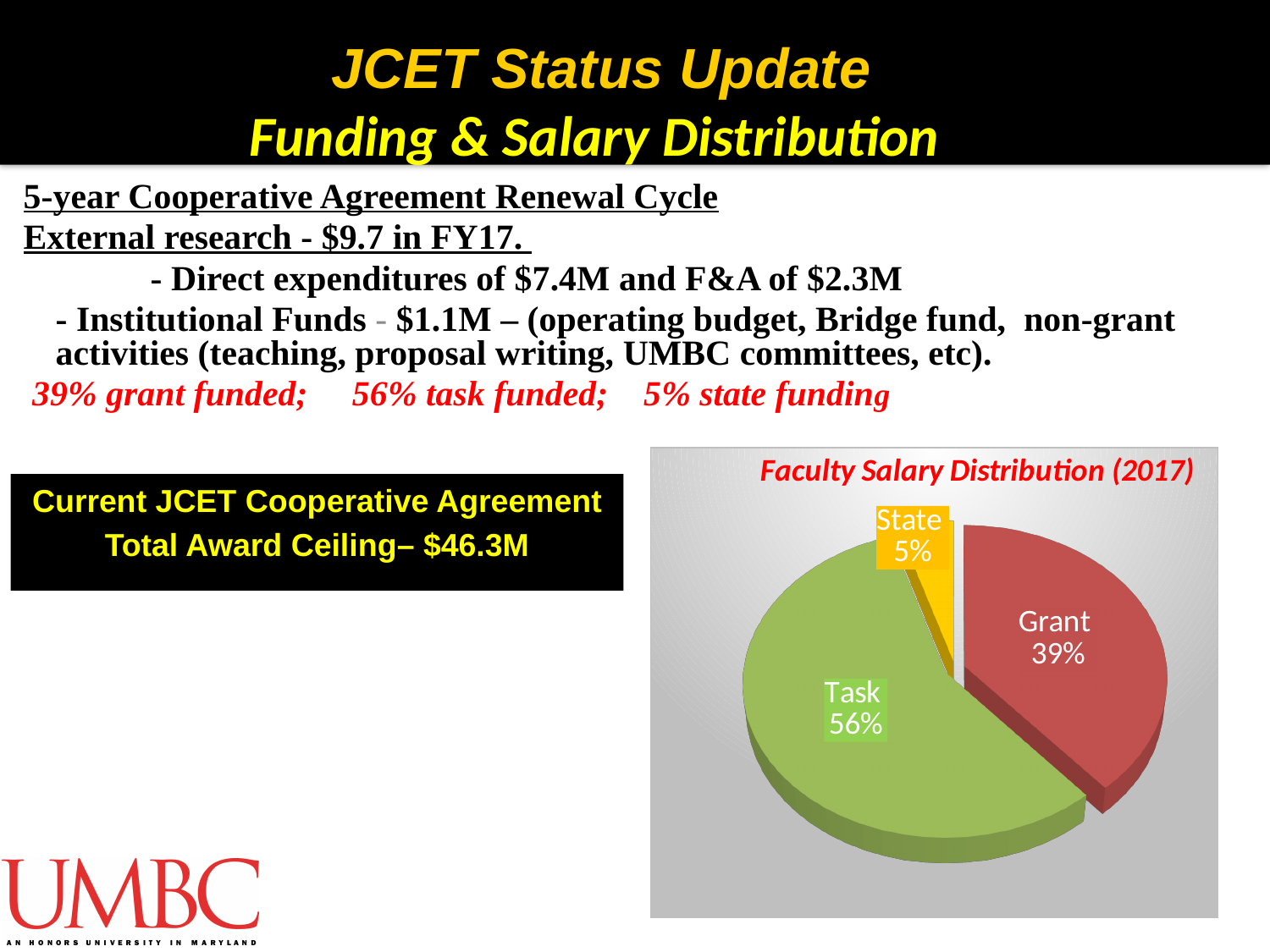
What share of the pie does Grant represent? 39% What is the difference in percentage points between the Task and Grant slices? 17 Which category has the smallest slice of the pie? State How many slices does the pie chart have? 3 Which is larger, the Grant slice or the State slice? Grant What colour is the Task slice of the pie chart? Green What share of the pie does Task represent? 56% What kind of chart is shown on the slide? Pie chart What is the difference in percentage points between the Grant and State slices? 34 What is the title of the pie chart? Faculty Salary Distribution (2017) Which category has the largest slice of the pie? Task What share of the pie does State represent? 5%